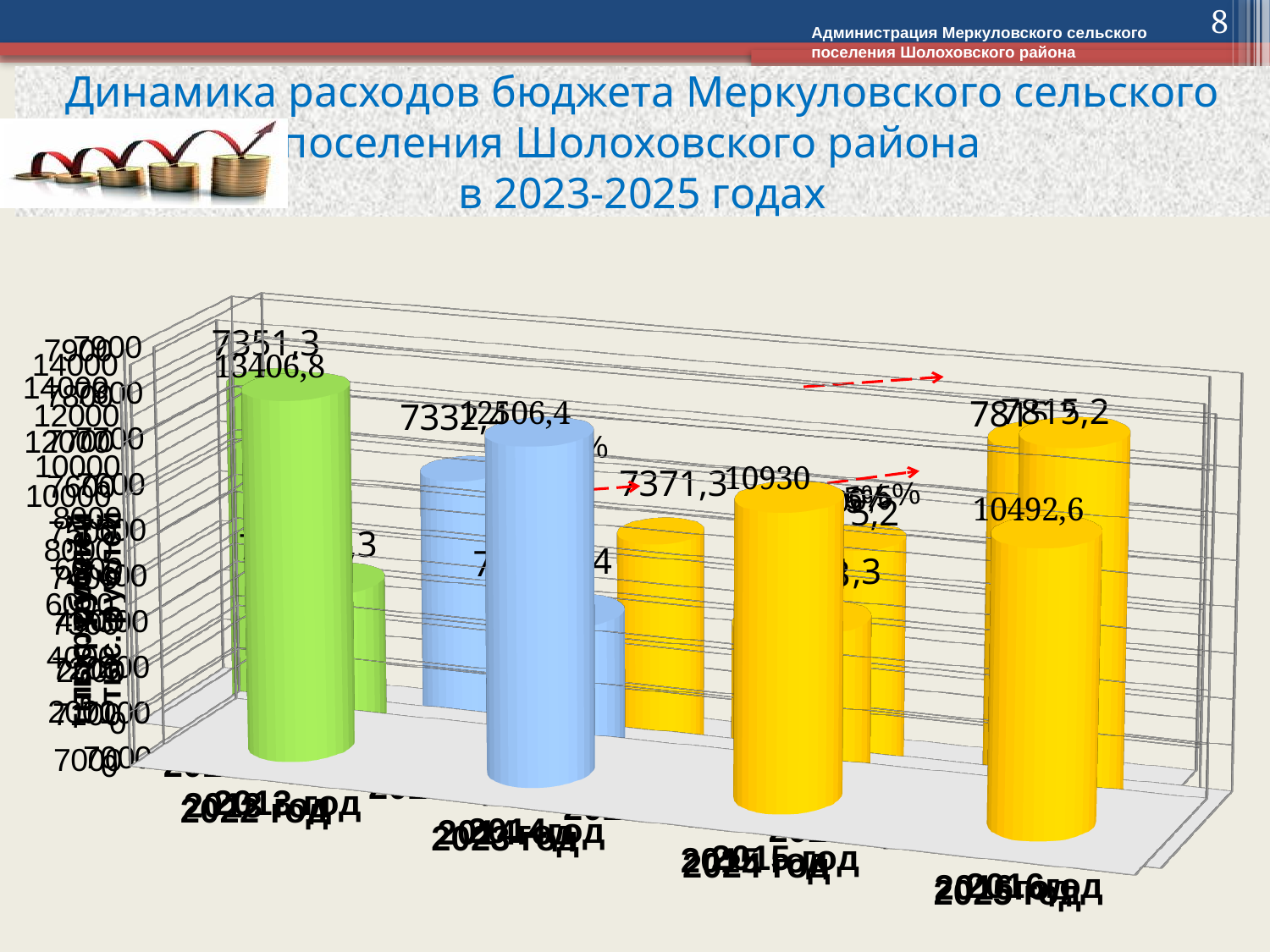
What is the title of the chart on the slide? Динамика расходов бюджета Меркуловского сельского поселения Шолоховского района в 2023-2025 годах Do the values of the large front bars rise or fall from left to right across the chart? fall What is the value printed on the tallest green bar at the left of the chart? 13406,8 Which colour is the tallest bar in the chart? green What is the value printed on the large blue bar in the front row? 12506,4 What kind of chart is shown on the slide? bar chart